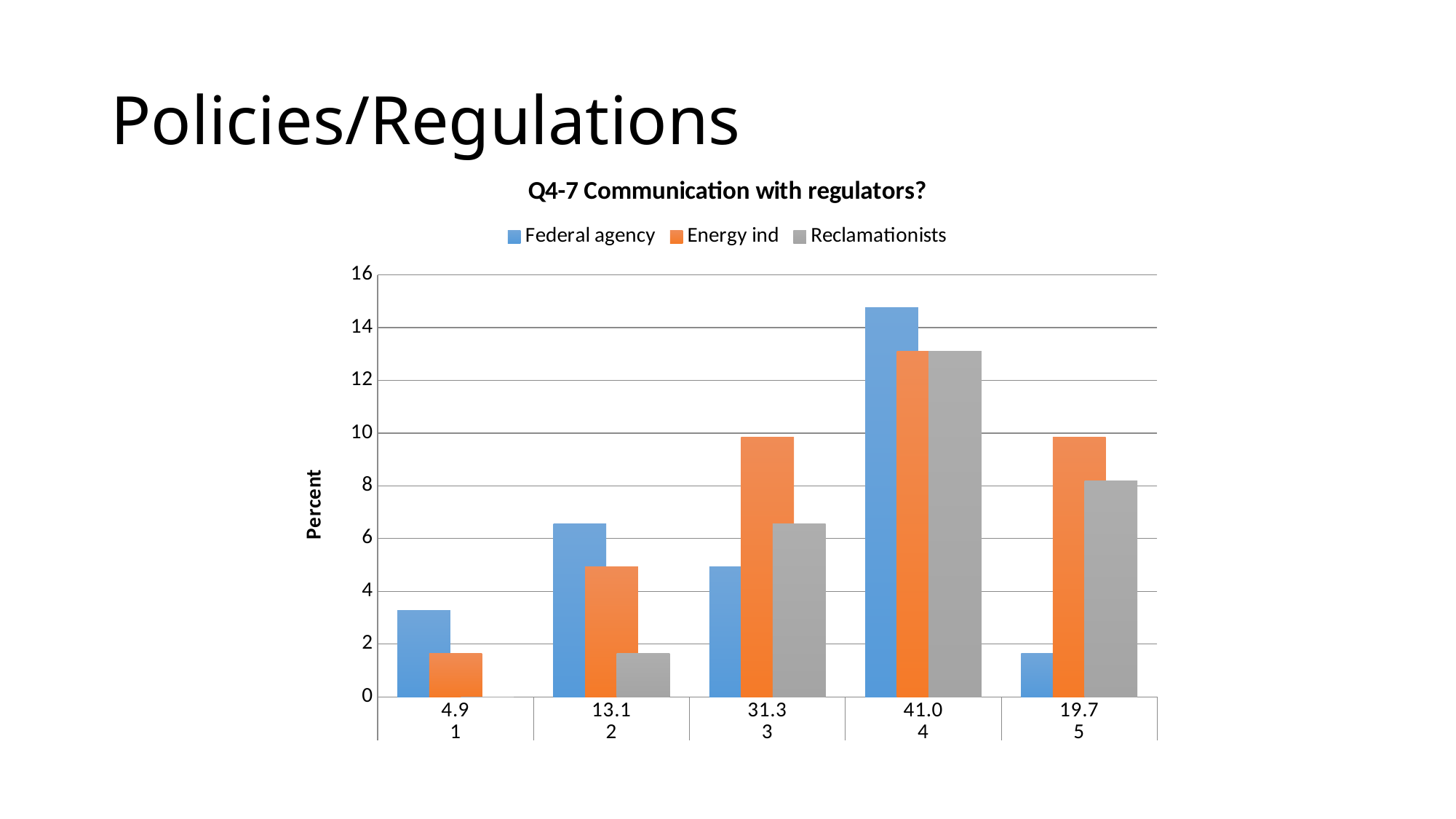
How many categories are shown along the x axis? 5 What kind of chart is shown on the slide? Bar chart What is the label on the vertical axis? Percent For category 5, which is larger: Energy ind or Reclamationists? Energy ind For which category is the Energy ind value lowest? 1 For category 3, which is larger: Energy ind or Federal agency? Energy ind Is the Federal agency value for category 4 greater or less than 14? greater Is the Reclamationists value for category 4 greater or less than 14? less How many series does the legend list? 3 For which category is the Federal agency value highest? 4 What is the title of the chart? Q4-7 Communication with regulators? Is the Federal agency value for category 1 greater or less than 4? less